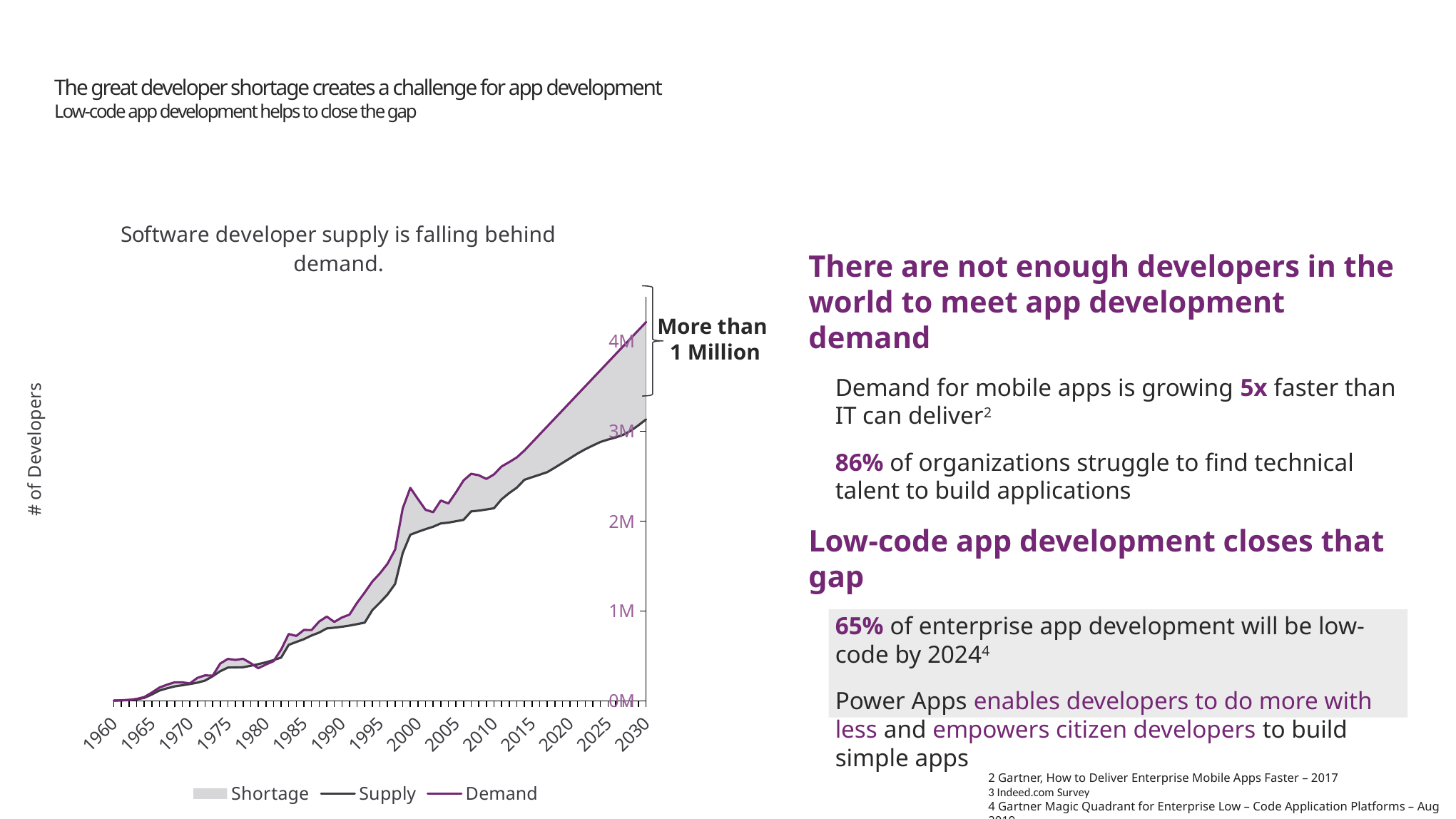
How many series does the chart legend list? 3 In 2030, which is larger, Demand or Supply? Demand According to the annotation on the chart, how large is the gap between Demand and Supply in 2030? More than 1 Million What kind of chart is shown on the slide? area and line chart Is the Supply value for 1980 greater or less than 1M? less What are the three entries in the chart legend? Shortage, Supply, Demand What is the title of the chart? Software developer supply is falling behind demand. Is the Supply value for 2030 greater or less than 3M? greater Do the Demand values generally rise or fall from 1960 to 2030? rise Is the Supply value for 2030 greater or less than 4M? less